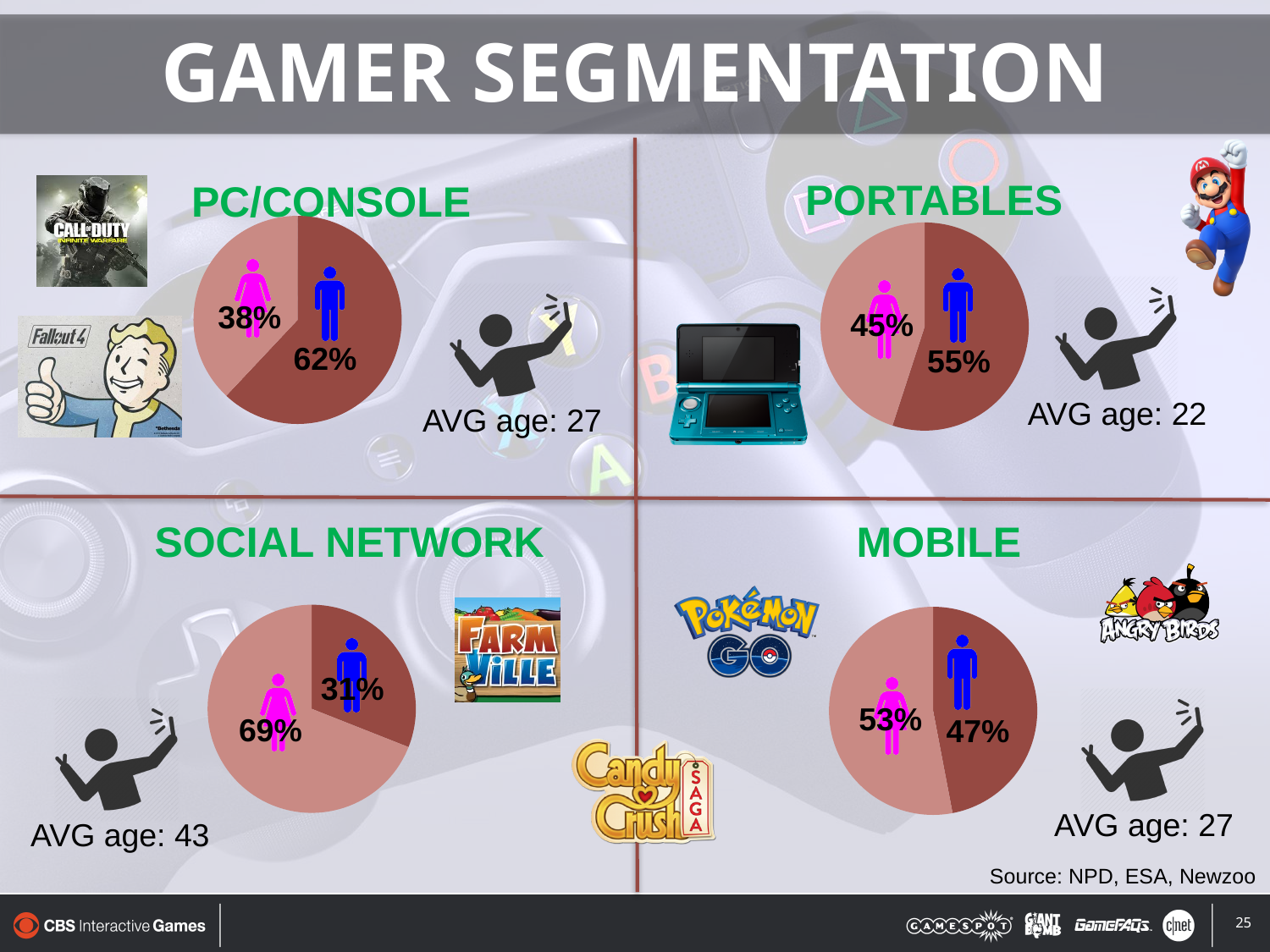
What kind of chart is used in each of the four segments on the slide? pie chart In the PORTABLES pie chart, what share of gamers is male? 55% In the PORTABLES pie chart, which is the larger slice, female or male? male In the MOBILE pie chart, what share of gamers is female? 53% In the PC/CONSOLE pie chart, what is the difference between the male and female shares? 24% How many slices does the SOCIAL NETWORK pie chart have? 2 In the PC/CONSOLE pie chart, what share of gamers is male? 62% In the SOCIAL NETWORK pie chart, what share of gamers is female? 69% What is the average age shown next to the SOCIAL NETWORK pie chart? 43 In the PC/CONSOLE pie chart, what share of gamers is female? 38% In the SOCIAL NETWORK pie chart, which is the larger slice, female or male? female In the MOBILE pie chart, what is the difference between the female and male shares? 6%